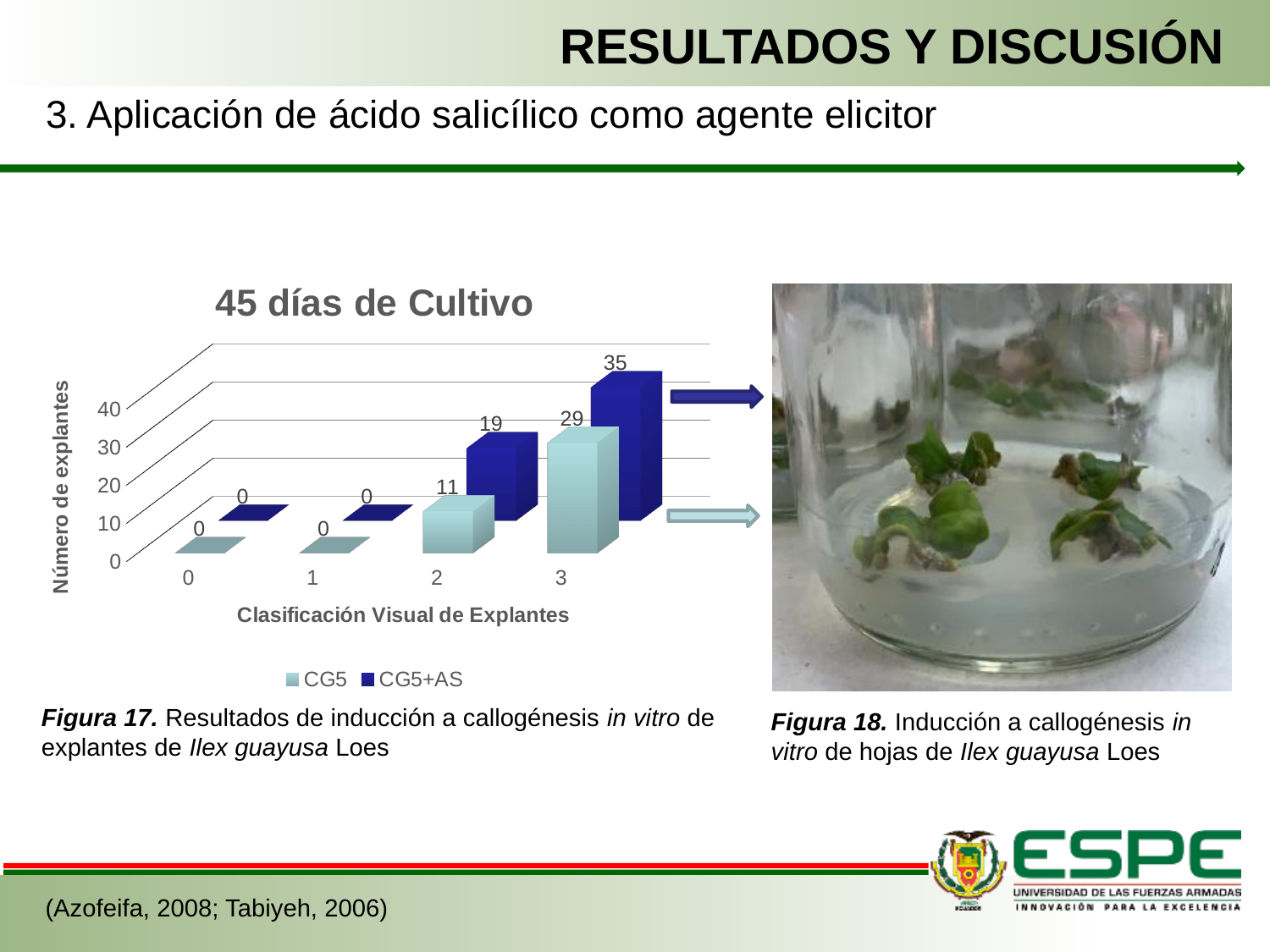
Do the CG5 values rise or fall as the classification increases from 0 to 3? rise What is the difference between CG5+AS and CG5 at classification 3? 6 Which is larger at classification 2, CG5 or CG5+AS? CG5+AS How many series does the chart legend list? 2 What is the title of the chart? 45 días de Cultivo What is the value for CG5 at classification 2? 11 What type of chart is shown on the slide? bar chart How many categories are shown on the x axis of the chart? 4 Which classification has the highest value for CG5+AS? 3 What is the label of the y axis of the chart? Número de explantes What is the value for CG5 at classification 3? 29 What is the value for CG5+AS at classification 2? 19